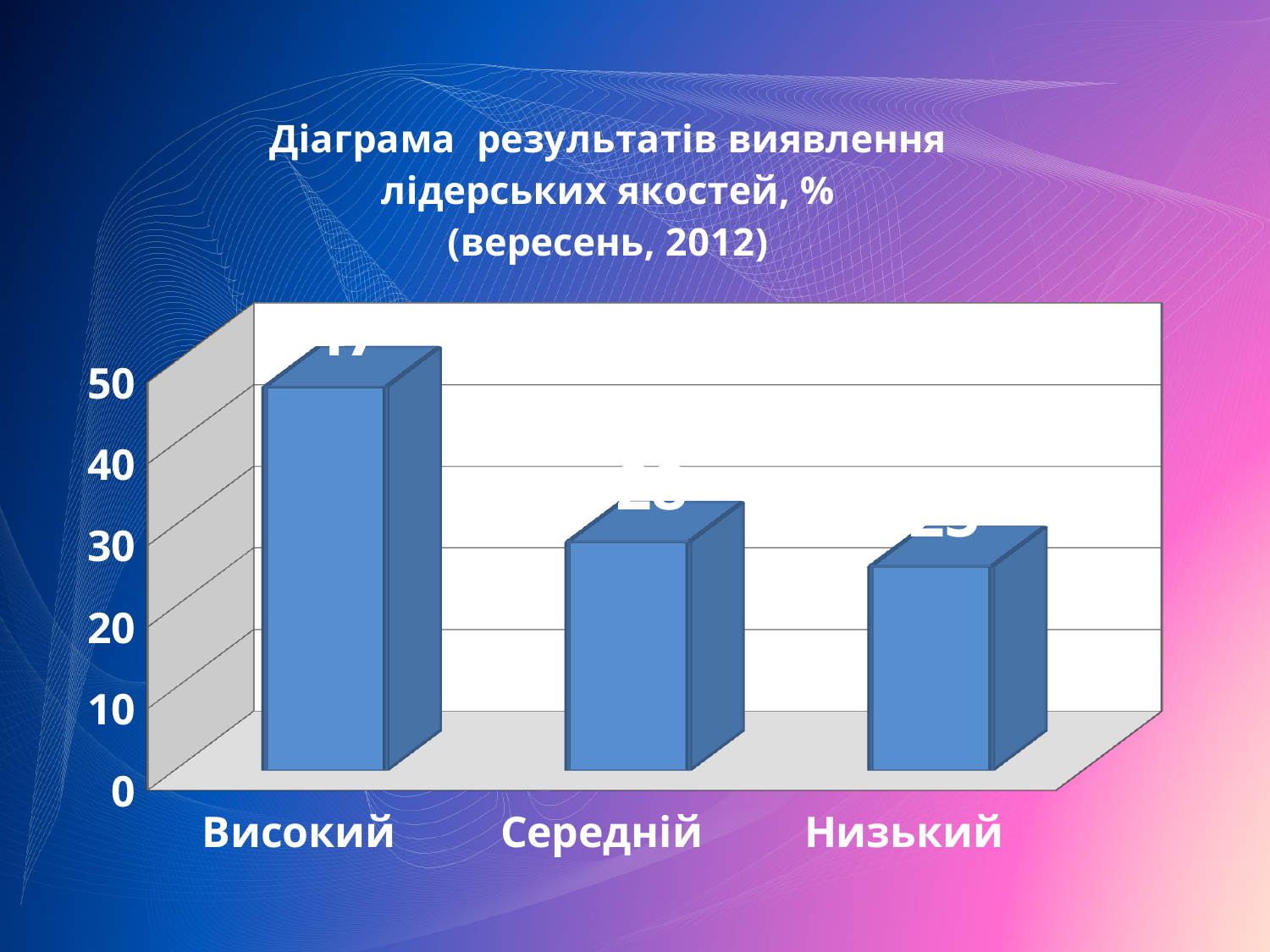
Which bar is taller, Високий or Середній? Високий Which category has the highest bar in the chart? Високий What kind of chart is shown on the slide? bar chart What month and year are given in the chart title? вересень, 2012 Is the value for Низький greater or less than 20? greater Which category has the lowest bar in the chart? Низький What is the highest value labelled on the vertical axis of the chart? 50 Do the bar values rise or fall from left to right across the categories? fall Which bar is taller, Середній or Низький? Середній Is the value for Середній greater or less than 20? greater How many categories are shown on the x axis of the chart? 3 Is the value for Високий greater or less than 40? greater